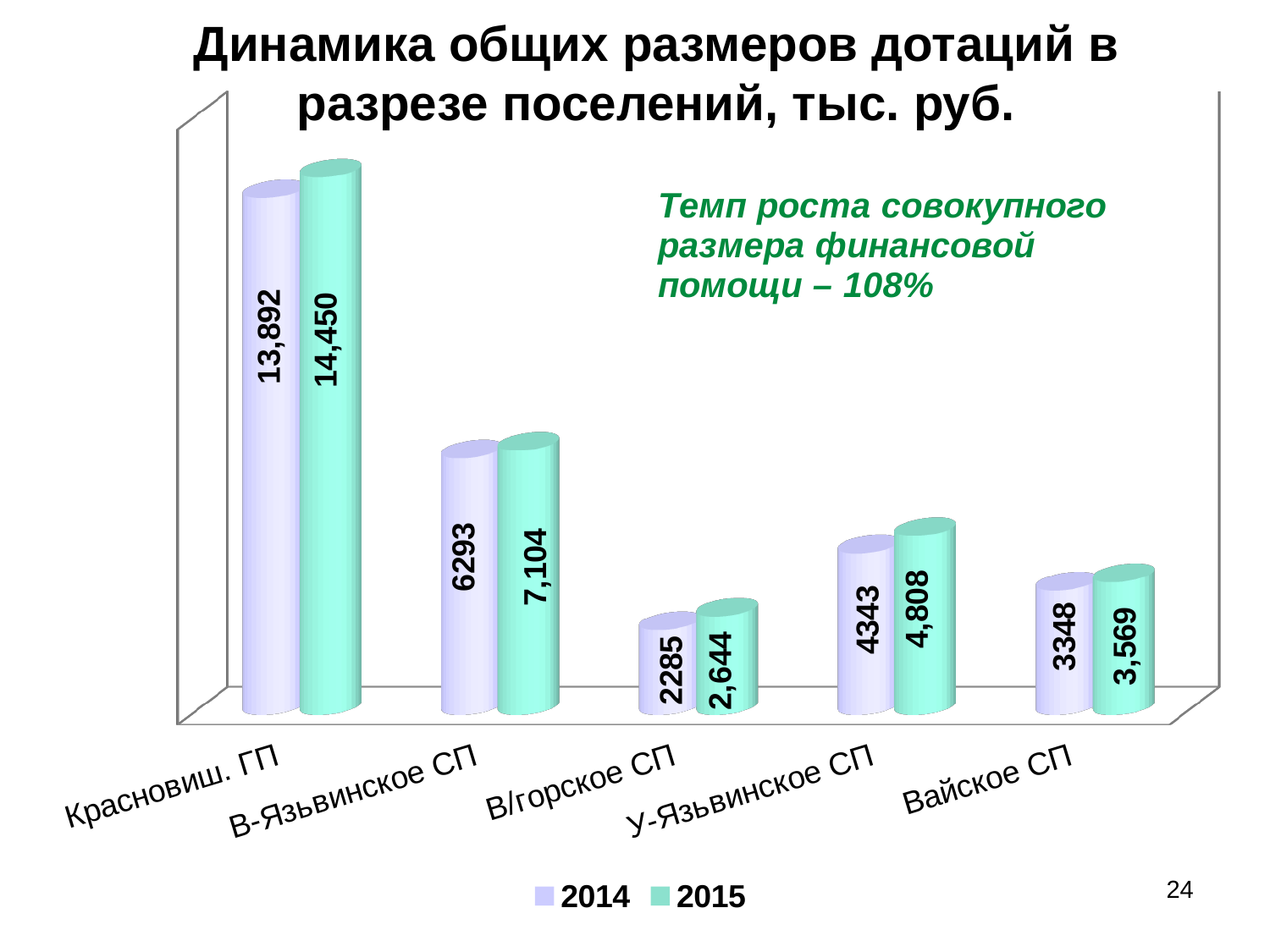
Which is larger for В-Язьвинское СП, the 2014 value or the 2015 value? 2015 What is the 2015 value for Вайское СП? 3,569 What kind of chart is shown on the slide? Bar chart What is the 2014 value for Красновиш. ГП? 13,892 Which category has the lowest 2014 value? В/горское СП How many series does the legend list? 2 Which category has the highest 2015 value? Красновиш. ГП What growth rate of total financial assistance is stated on the slide? 108% What is the 2015 value for В-Язьвинское СП? 7,104 How many categories are shown on the x axis? 5 What is the 2014 value for В/горское СП? 2285 What is the difference between the 2015 and 2014 values for У-Язьвинское СП? 465